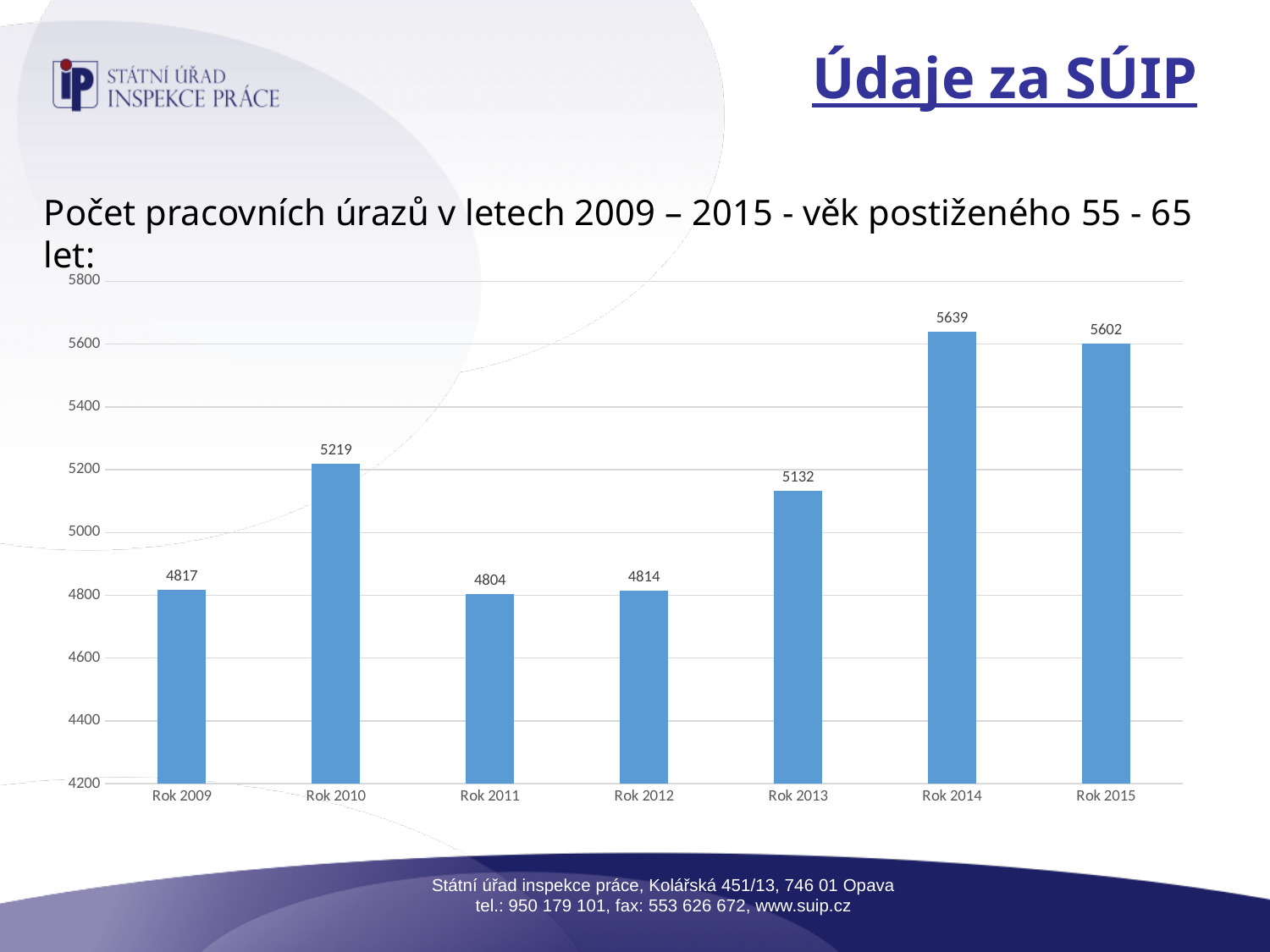
Do the values rise or fall from Rok 2012 to Rok 2014? rise What is the value for Rok 2015? 5602 What kind of chart is shown on the slide? bar chart How many years are shown on the x axis? 7 Is the value for Rok 2012 greater or less than 5000? less Which is larger, the value for Rok 2013 or the value for Rok 2010? Rok 2010 What is the difference between the values for Rok 2010 and Rok 2011? 415 What is the value for Rok 2010? 5219 Which year has the lowest value? Rok 2011 What is the difference between the values for Rok 2014 and Rok 2009? 822 Which year has the highest value? Rok 2014 What is the value for Rok 2013? 5132